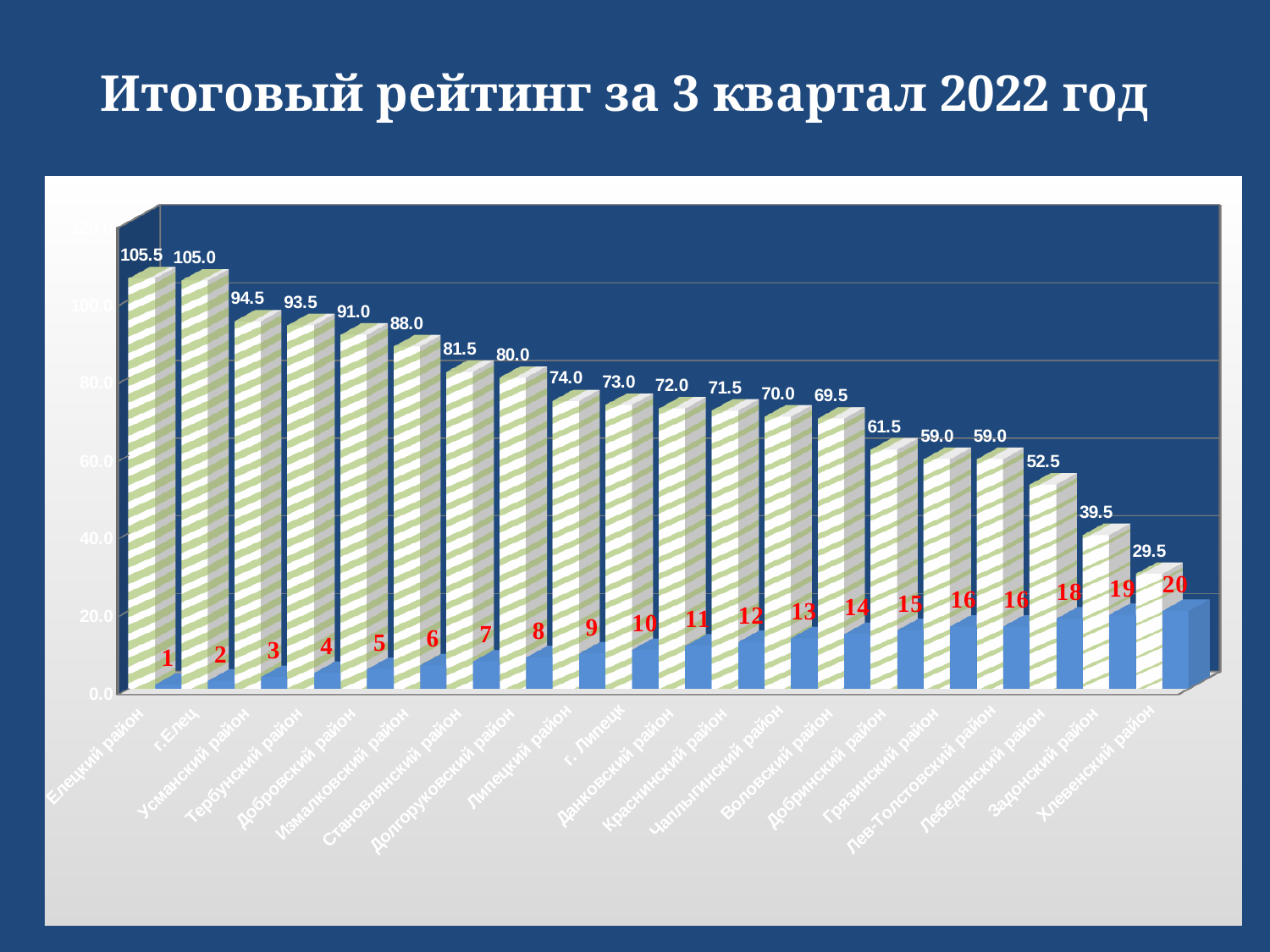
What is the difference between the values for Усманский район and Тербунский район? 1.0 What kind of chart is shown on the slide? Bar chart Which is larger, the value for Измалковский район or the value for Становлянский район? Измалковский район What is the difference between the values for Елецкий район and Хлевенский район? 76.0 Which category has the highest value? Елецкий район What is the value for г. Липецк? 73.0 Which category has the lowest value? Хлевенский район What is the value for Добринский район? 61.5 Do the values rise or fall from left to right along the x axis? Fall How many categories are shown on the chart? 20 What is the value for Хлевенский район? 29.5 What is the value for Елецкий район? 105.5